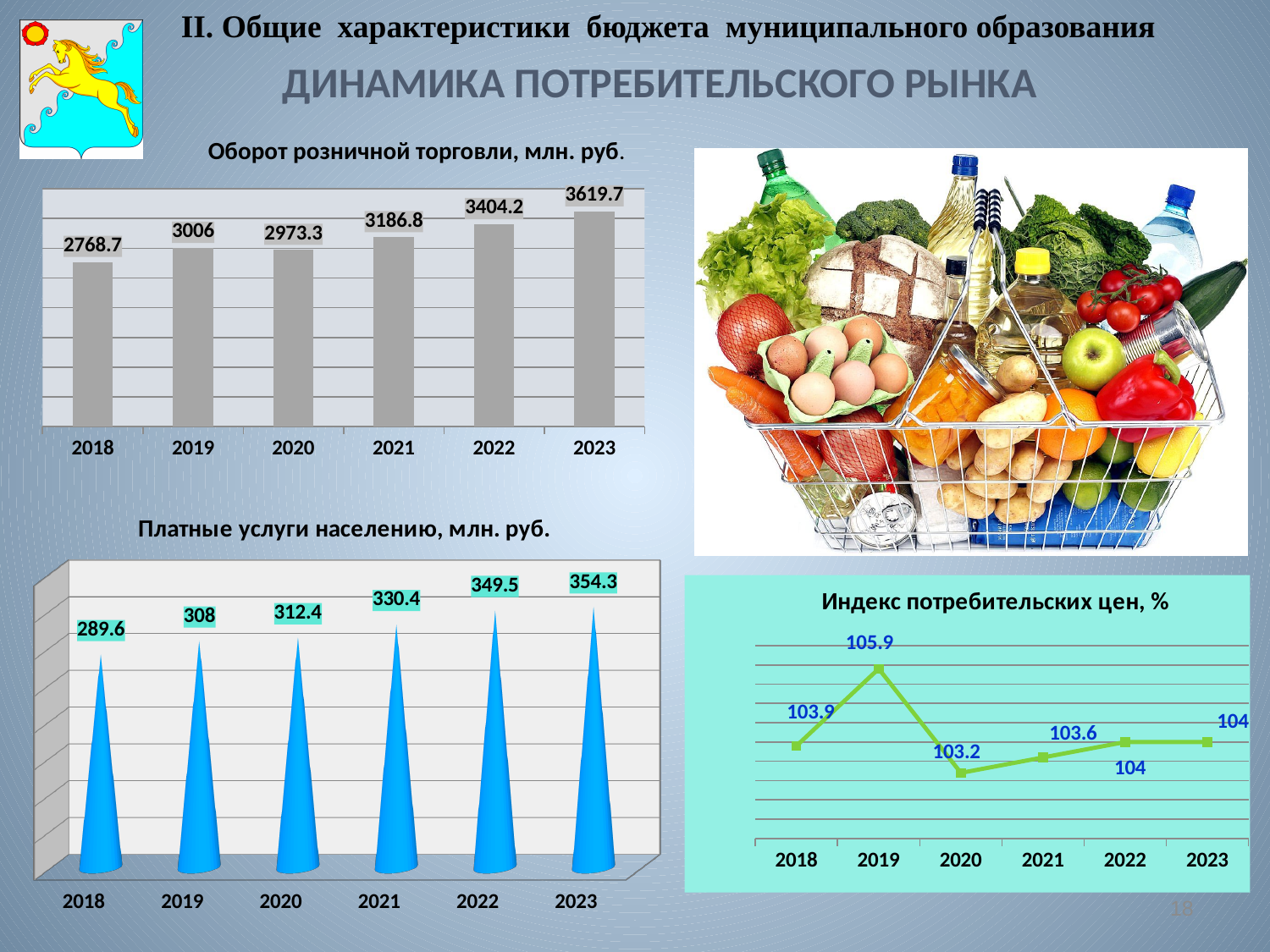
In the chart titled "Оборот розничной торговли, млн. руб.", what is the value for 2023? 3619.7 In the chart titled "Оборот розничной торговли, млн. руб.", which is larger, the value for 2019 or the value for 2020? 2019 What kind of chart is the one titled "Индекс потребительских цен, %"? line chart What kind of chart is the one titled "Платные услуги населению, млн. руб."? bar chart In the chart titled "Платные услуги населению, млн. руб.", which year has the highest value? 2023 In the chart titled "Платные услуги населению, млн. руб.", what is the value for 2021? 330.4 In the chart titled "Индекс потребительских цен, %", what is the value for 2019? 105.9 In the chart titled "Платные услуги населению, млн. руб.", do the values rise or fall from 2018 to 2023? rise In the chart titled "Оборот розничной торговли, млн. руб.", which year has the lowest value? 2018 In the chart titled "Оборот розничной торговли, млн. руб.", how many years are shown on the x axis? 6 In the chart titled "Оборот розничной торговли, млн. руб.", what is the difference between the values for 2023 and 2022? 215.5 In the chart titled "Индекс потребительских цен, %", which year has the lowest value? 2020